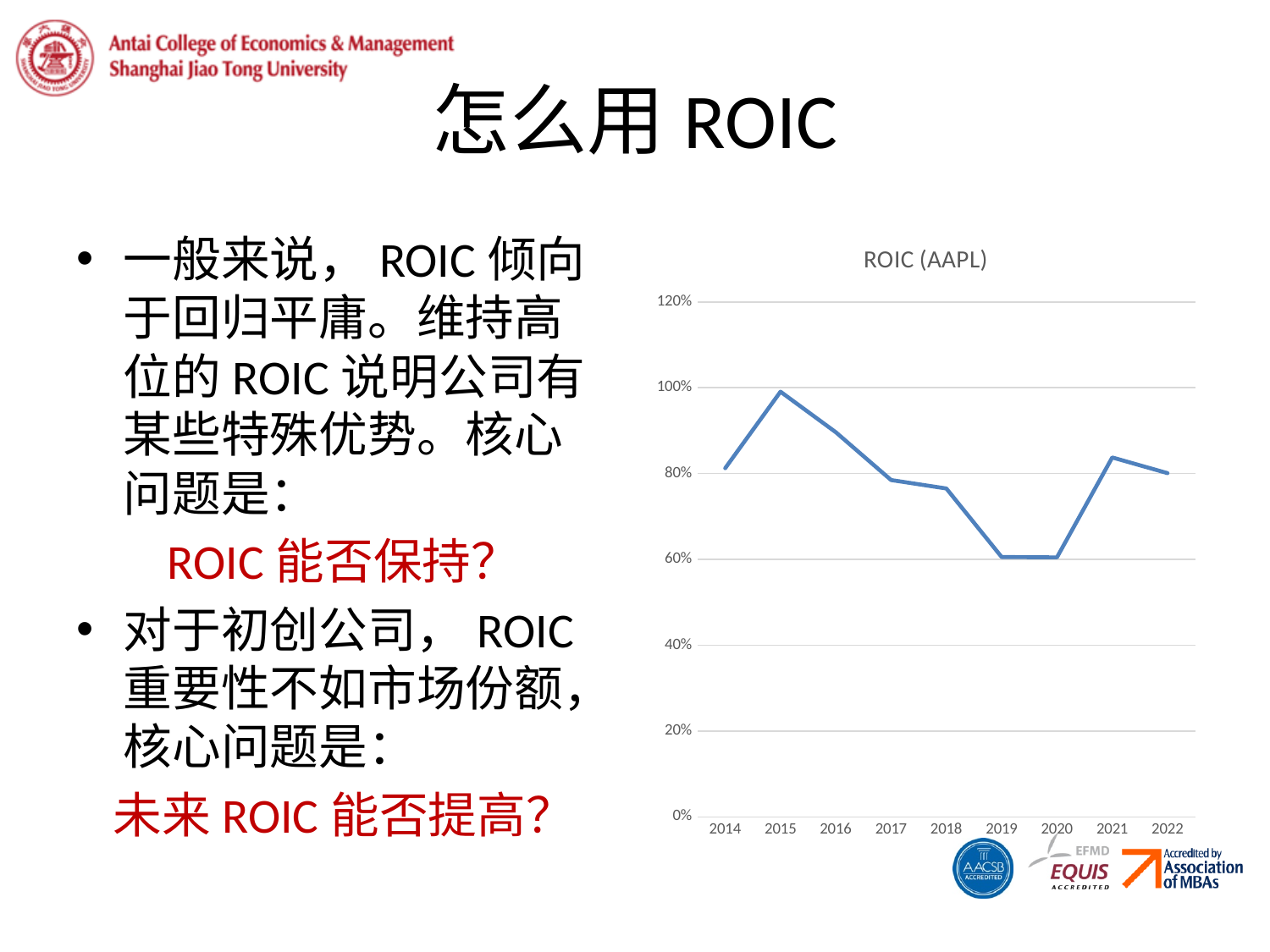
Which year has the highest ROIC value in the chart? 2015 How many years are plotted on the x axis of the chart? 9 Is the ROIC value for 2019 greater or less than 80%? less Which year has the larger ROIC value, 2021 or 2020? 2021 Does the ROIC value rise or fall from 2015 to 2019? fall What type of chart is shown on the slide? line chart What is the title of the chart? ROIC (AAPL) Is the ROIC value for 2018 greater or less than 60%? greater Is the ROIC value for 2015 greater or less than 80%? greater Does the ROIC value rise or fall from 2020 to 2021? rise Which year has the larger ROIC value, 2015 or 2019? 2015